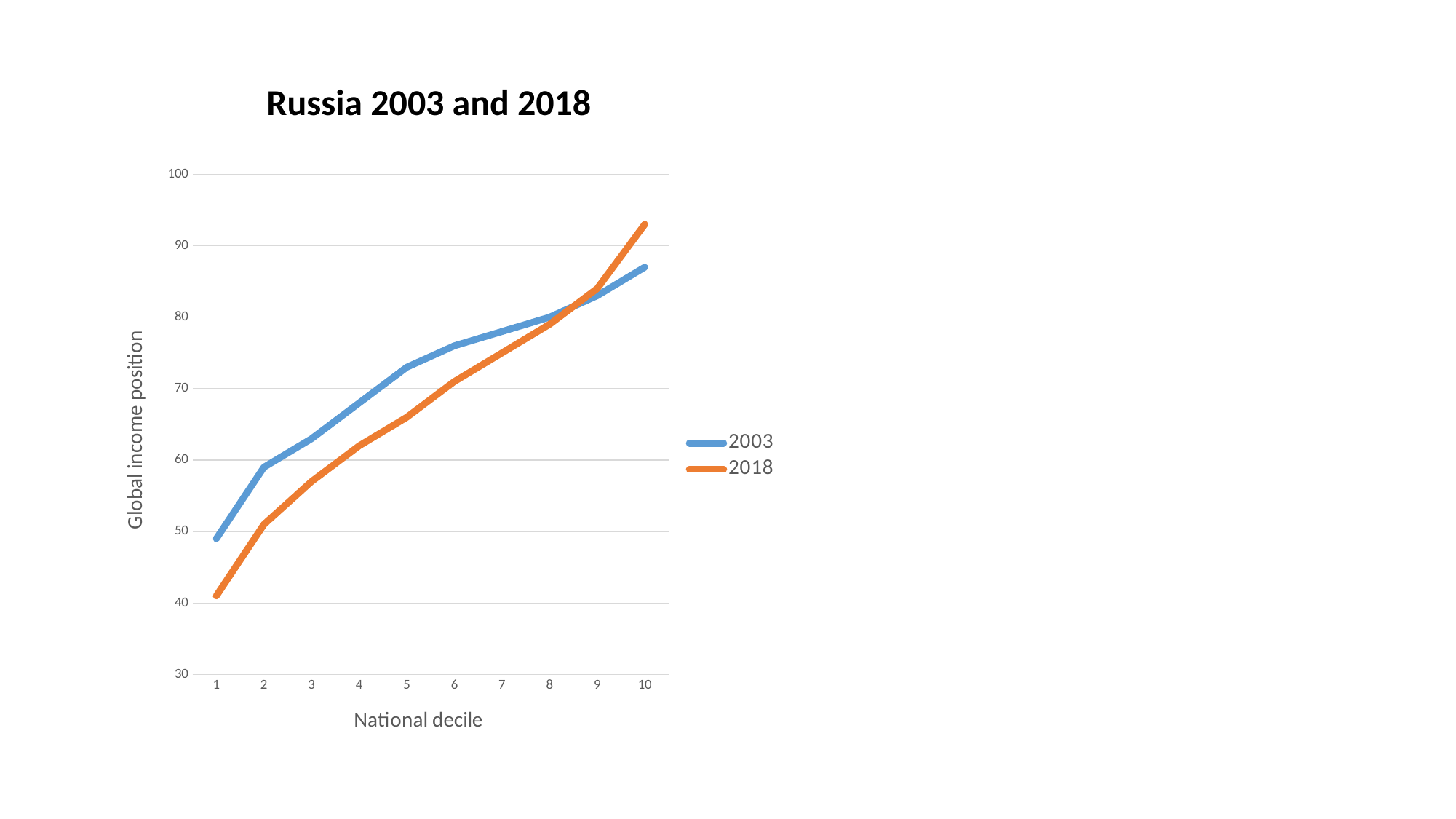
What is the label of the y axis? Global income position Is the value for the 2018 series at decile 1 greater or less than 50? less At decile 10, which series has the larger value, 2003 or 2018? 2018 How many national deciles are plotted along the x axis? 10 What kind of chart is shown on the slide? line chart Is the value for the 2018 series at decile 10 greater or less than 90? greater How many series does the legend list? 2 At decile 3, which series has the larger value, 2003 or 2018? 2003 Is the value for the 2003 series at decile 10 greater or less than 80? greater At which national decile does the 2003 series reach its lowest value? 1 Do the values for the 2018 series rise or fall as the national decile increases? rise What is the title of the chart? Russia 2003 and 2018